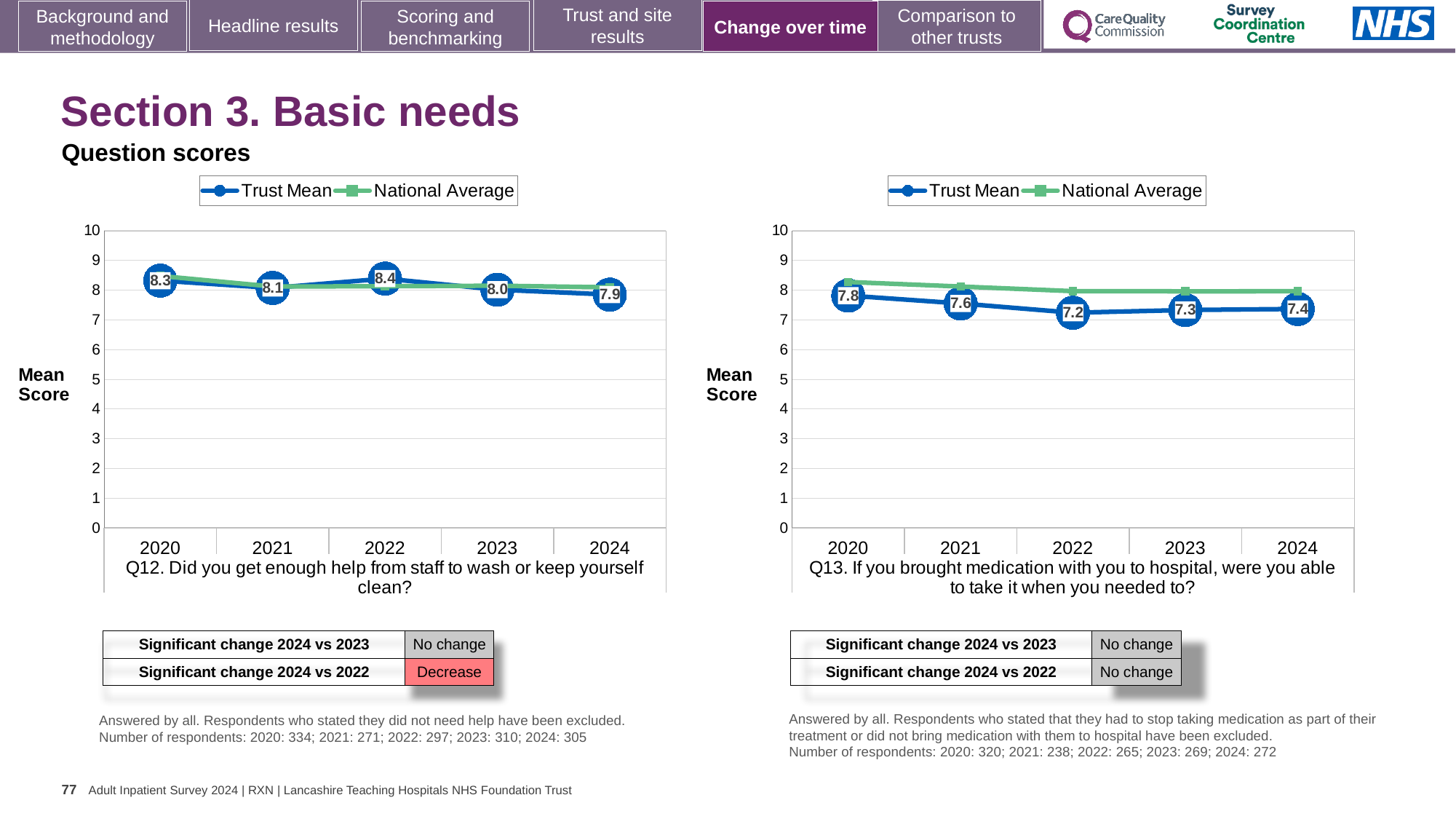
How many series does the legend of the Q13 chart (right) list? 2 In the Q13 chart (right), what is the Trust Mean for 2020? 7.8 In the Q13 chart (right), is the Trust Mean higher in 2020 or in 2024? 2020 In the Q12 chart (left), what is the difference between the Trust Mean in 2022 and in 2024? 0.5 In the Q13 chart (right), which year has the lowest Trust Mean? 2022 How many years are plotted on the x axis of the Q12 chart (left)? 5 In the Q13 chart (right), is the National Average for 2020 greater or less than 7? greater What type of chart is used for Q12 (left)? Line chart In the Q13 chart (right), what is the Trust Mean for 2022? 7.2 In the Q12 chart (left), what is the Trust Mean for 2022? 8.4 In the Q12 chart (left), what is the Trust Mean for 2024? 7.9 In the Q12 chart (left), which year has the highest Trust Mean? 2022